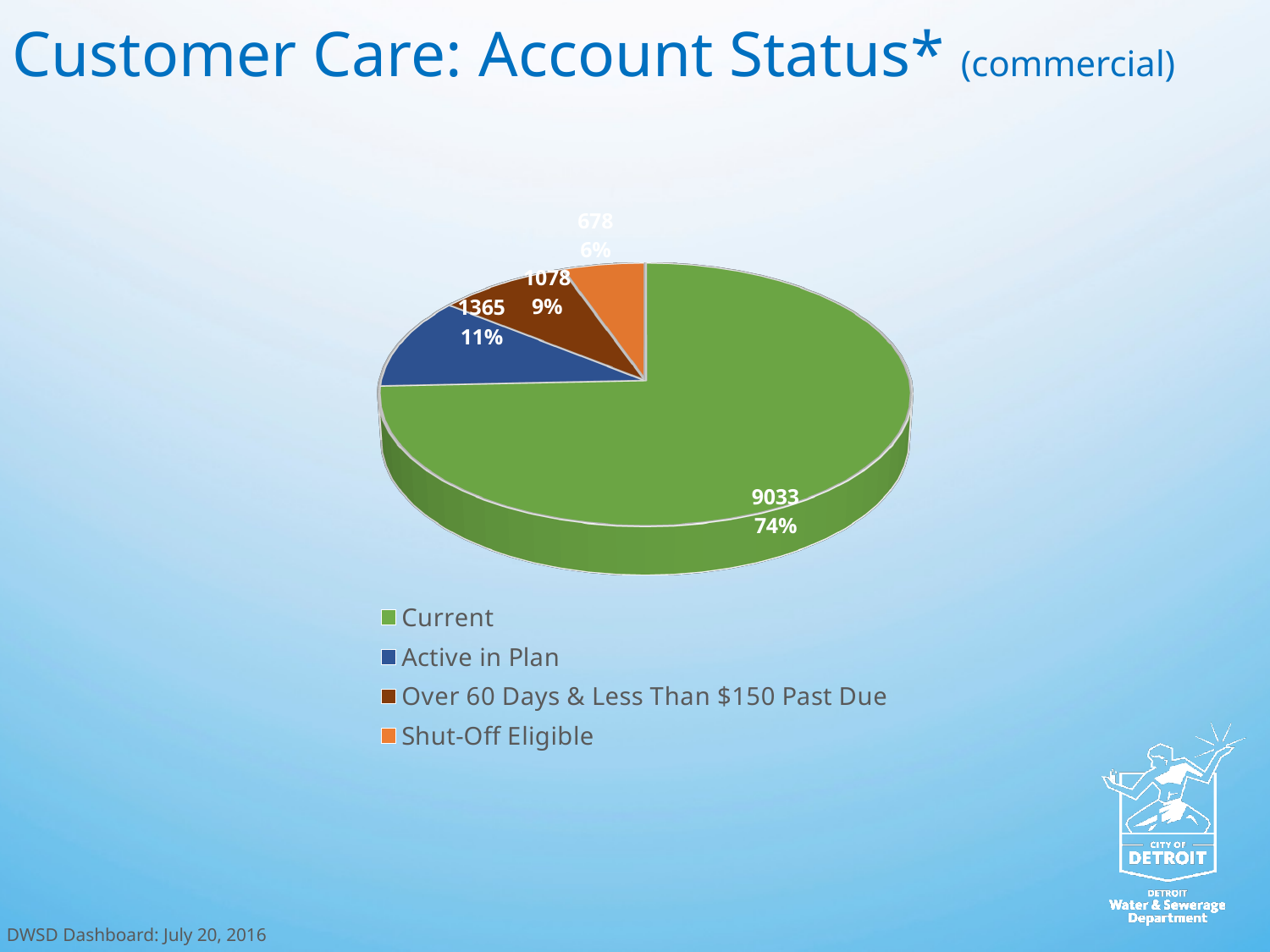
Which category has the largest slice of the pie? Current How many accounts are Shut-Off Eligible? 678 What share of the pie does the Shut-Off Eligible slice represent? 6% Which is larger, the Active in Plan slice or the Over 60 Days & Less Than $150 Past Due slice? Active in Plan How many accounts are Active in Plan? 1365 How many slices does the pie chart have? 4 How many accounts are in the Current category? 9033 Which category has the smallest slice of the pie? Shut-Off Eligible What share of the pie does the Current slice represent? 74% What is the difference between the number of Active in Plan accounts and the number of Shut-Off Eligible accounts? 687 How many accounts are Over 60 Days & Less Than $150 Past Due? 1078 What kind of chart is shown on the slide? Pie chart